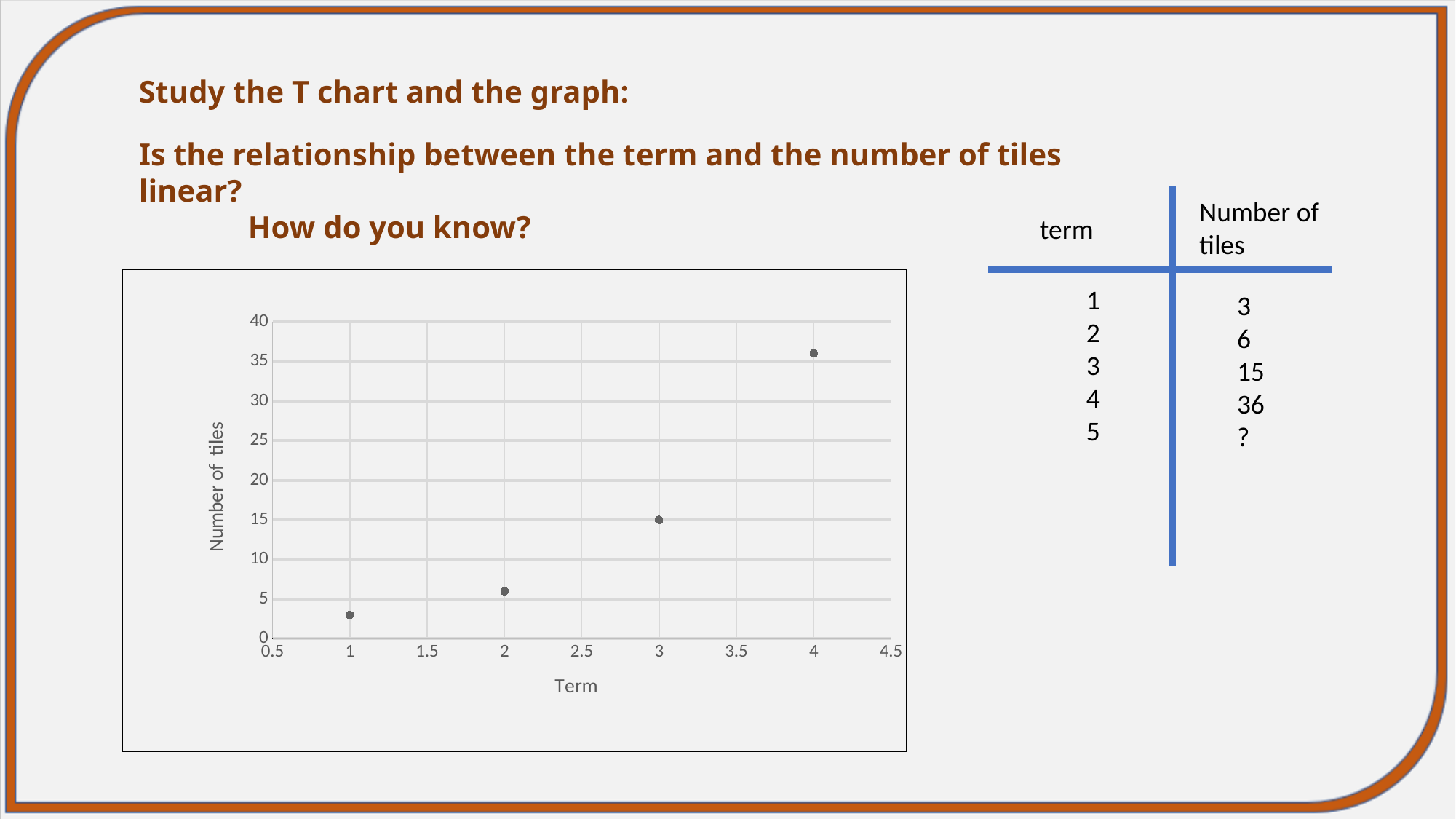
What is the label of the x axis of the chart? Term What is the number of tiles for term 4? 36 Do the values rise or fall as the term increases along the x axis? rise Is the number of tiles for term 4 greater or less than 35? greater Which term has the highest number of tiles? 4 What is the number of tiles for term 3? 15 Which term has the lowest number of tiles? 1 How many data points are plotted on the chart? 4 What kind of chart is shown on the slide? scatter plot What is the number of tiles for term 1? 3 What is the difference in number of tiles between term 4 and term 3? 21 What is the label of the y axis of the chart? Number of tiles